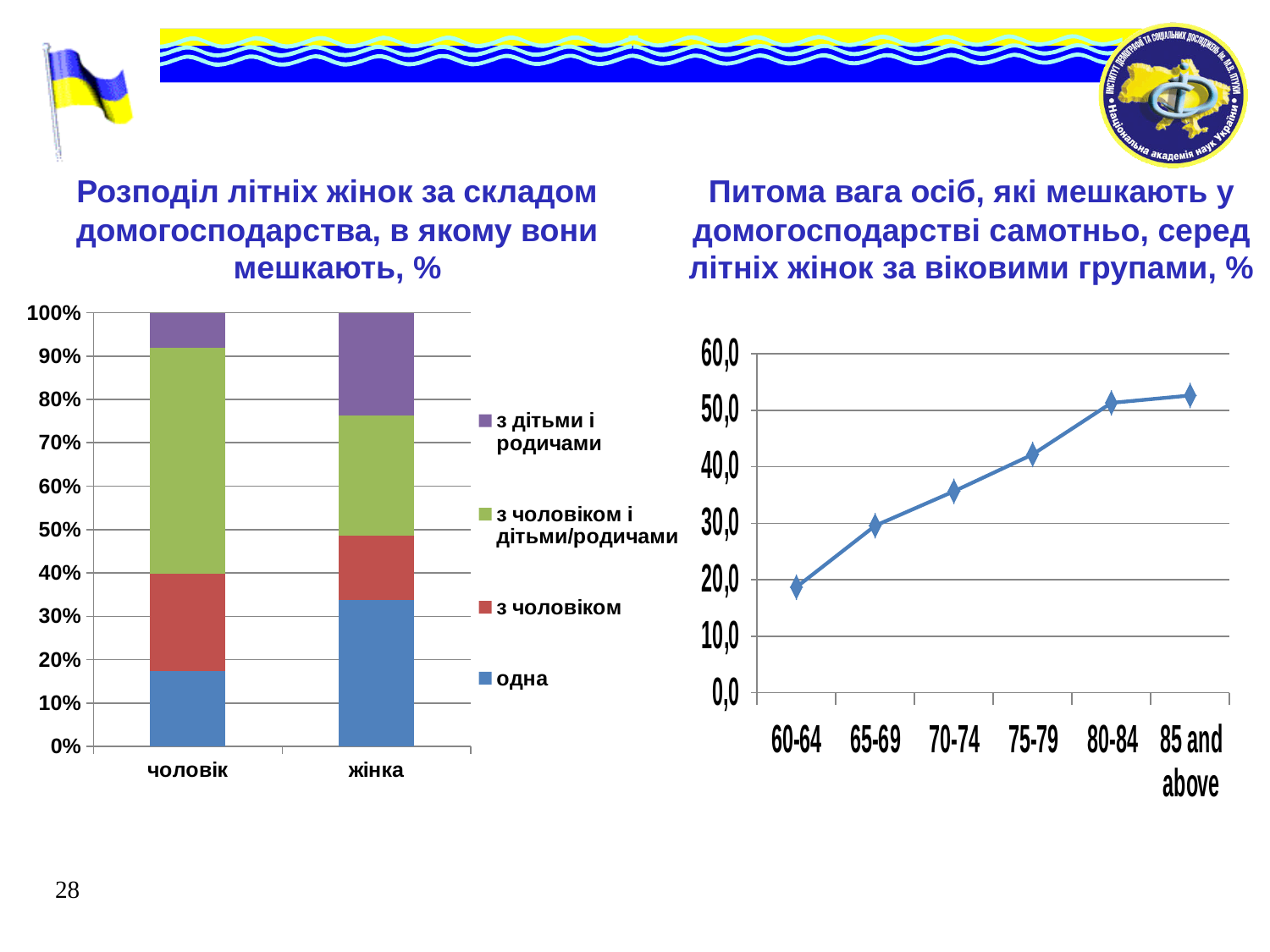
How many categories are shown on the x axis of the left chart? 2 What kind of chart is the left chart, 'Розподіл літніх жінок за складом домогосподарства, в якому вони мешкають, %'? stacked bar chart In the right chart, is the value for the 60-64 age group greater or less than 20,0? less In the right chart, which age group has the highest value? 85 and above In the left chart, which category has the larger 'з чоловіком і дітьми/родичами' share, 'чоловік' or 'жінка'? чоловік In the right chart, do the values rise or fall as the age group increases? rise How many age groups are plotted on the right chart? 6 In the left chart, is the 'одна' share for 'жінка' greater or less than 30%? greater What kind of chart is the right chart, 'Питома вага осіб, які мешкають у домогосподарстві самотньо, серед літніх жінок за віковими групами, %'? line chart In the left chart, is the 'одна' share for 'чоловік' greater or less than 20%? less How many series does the legend of the left chart list? 4